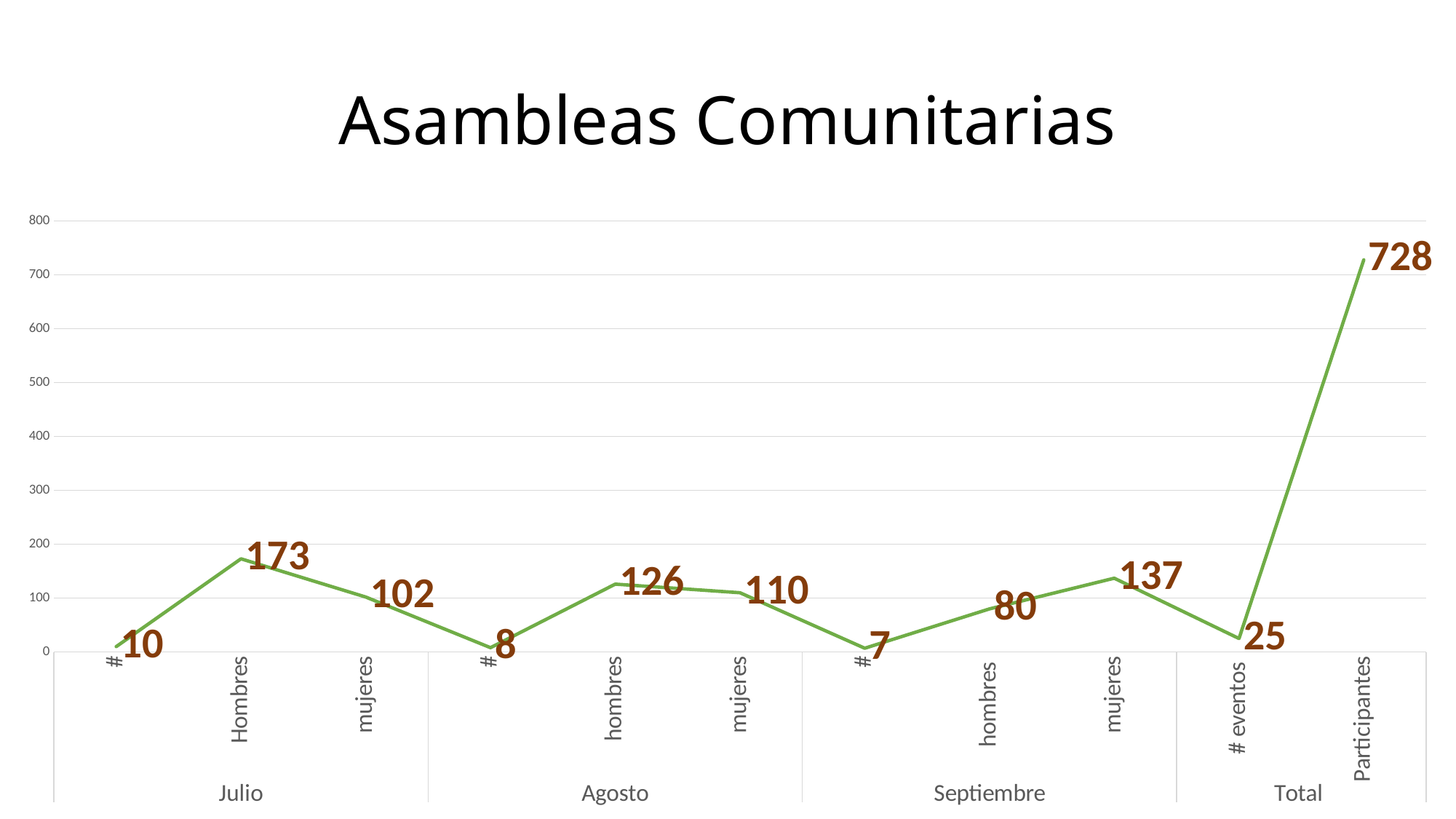
What is the value for # eventos under Total? 25 What is the difference between Hombres in Julio and hombres in Septiembre? 93 What is the value for Participantes under Total? 728 What kind of chart is shown? line chart How many data points are plotted on the chart? 11 Which category has the highest value? Participantes What is the value for mujeres in Agosto? 110 Which is larger, mujeres in Septiembre or mujeres in Julio? mujeres in Septiembre What is the value for Hombres in Julio? 173 What is the title of the chart? Asambleas Comunitarias What is the value for hombres in Agosto? 126 Which category has the lowest value? # (Septiembre)